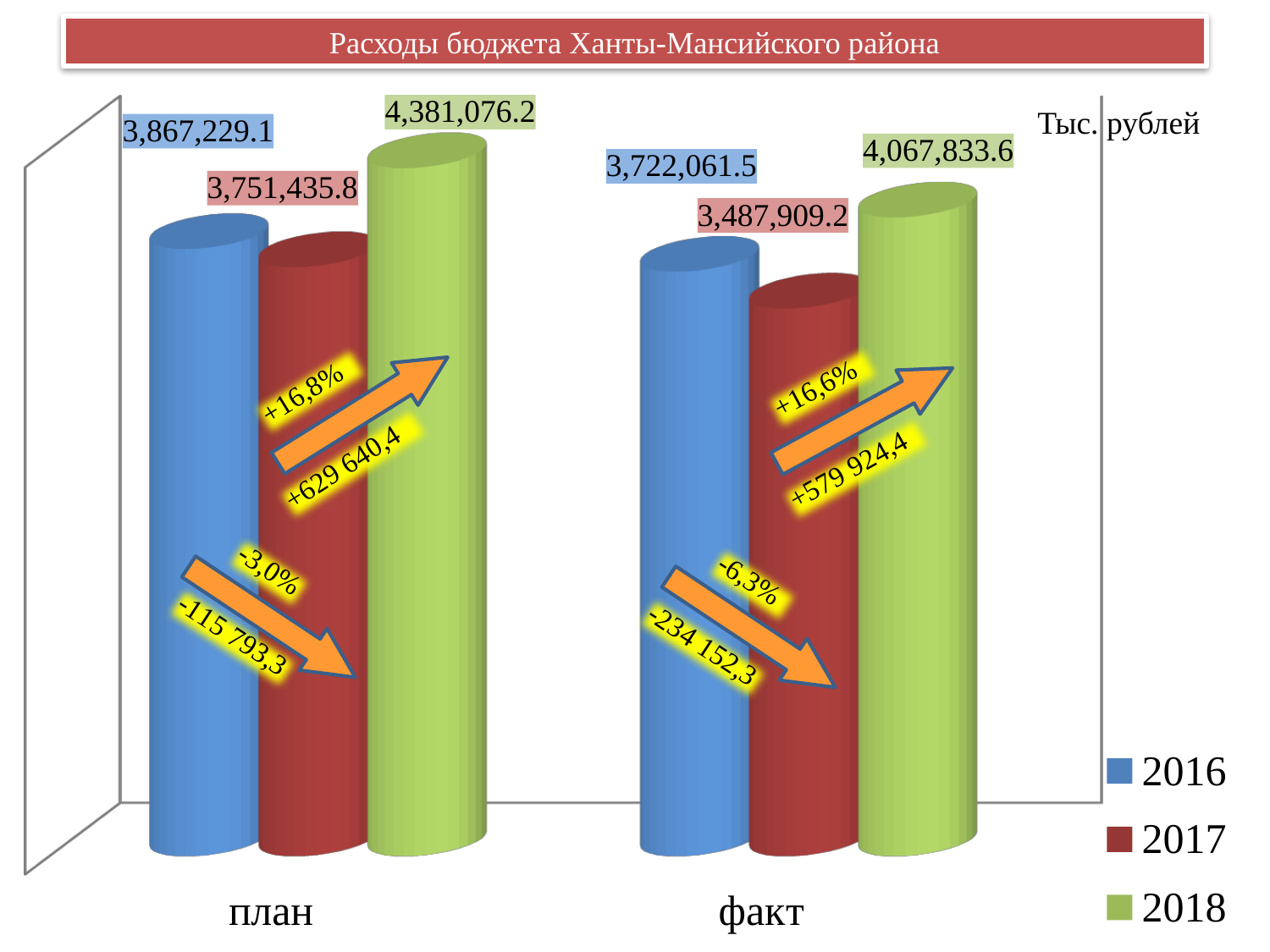
What is the title of the chart? Расходы бюджета Ханты-Мансийского района What is the value for 2018 in the план category? 4,381,076.2 Which is larger: the 2016 value for план or the 2016 value for факт? план What is the value for 2016 in the план category? 3,867,229.1 Which year has the highest value in the факт category? 2018 How many categories are shown on the x axis? 2 How many series does the legend list? 3 What kind of chart is shown on the slide? bar chart What is the difference between the 2018 and 2017 values in the план category? 629,640.4 What is the difference between the 2016 and 2017 values in the факт category? 234,152.3 What is the value for 2017 in the факт category? 3,487,909.2 Which year has the lowest value in the план category? 2017